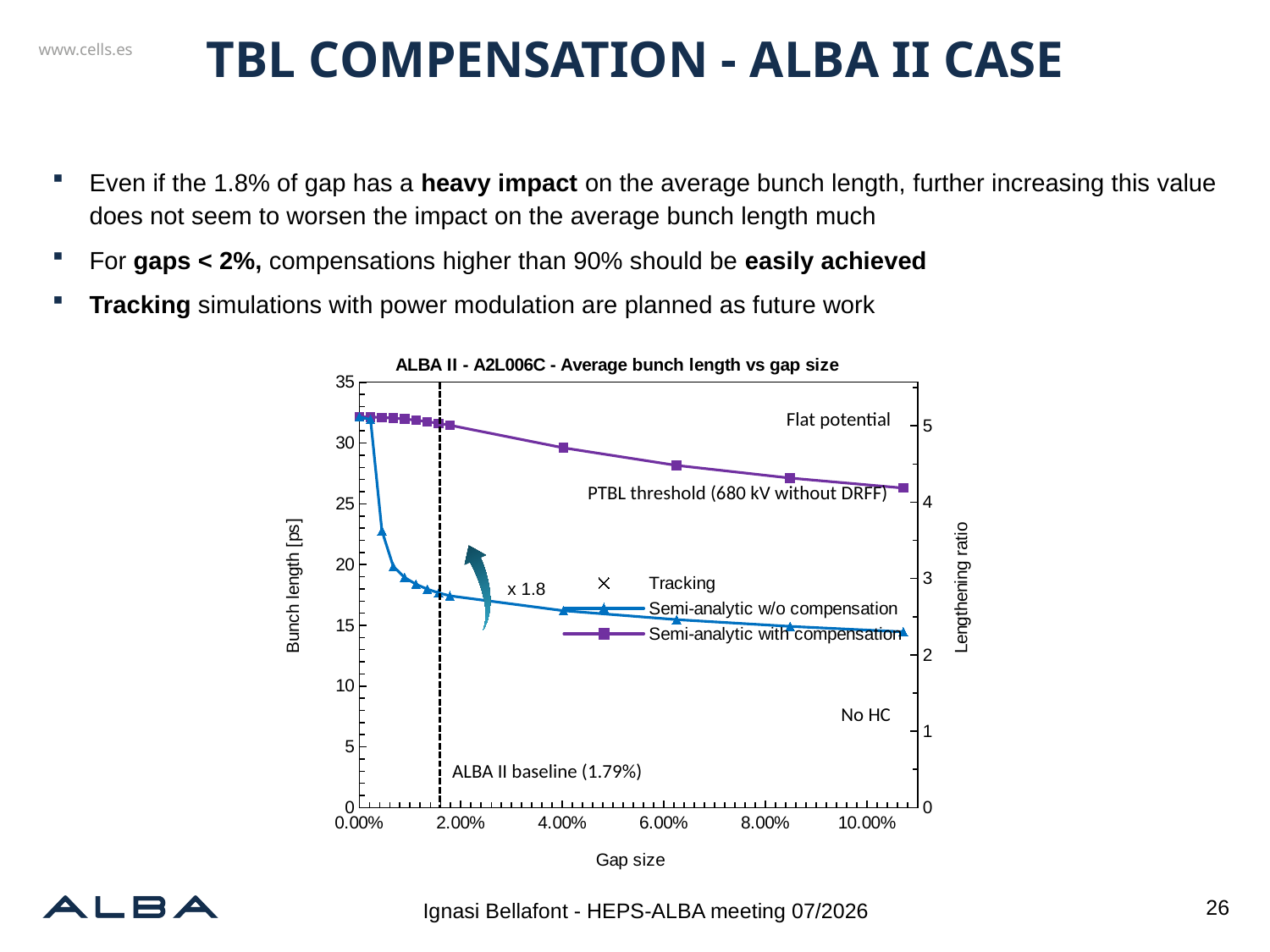
What kind of chart is shown on the slide? line chart Does the 'Semi-analytic with compensation' series rise or fall as gap size increases? fall How many series does the chart legend list? 3 What is the label of the left vertical axis? Bunch length [ps] At a gap size of 6.00%, which series has the larger bunch length: 'Semi-analytic with compensation' or 'Semi-analytic w/o compensation'? Semi-analytic with compensation What is the title of the chart? ALBA II - A2L006C - Average bunch length vs gap size Is the bunch length for 'Semi-analytic with compensation' at a gap size of 10.00% greater or less than 25? greater Is the bunch length for 'Semi-analytic w/o compensation' at a gap size of 4.00% greater or less than 20? less Which series has the lower bunch length at a gap size of 8.00%? Semi-analytic w/o compensation Is the bunch length for 'Semi-analytic with compensation' at a gap size of 0.00% greater or less than 30? greater Does the 'Semi-analytic w/o compensation' series rise or fall as gap size increases? fall